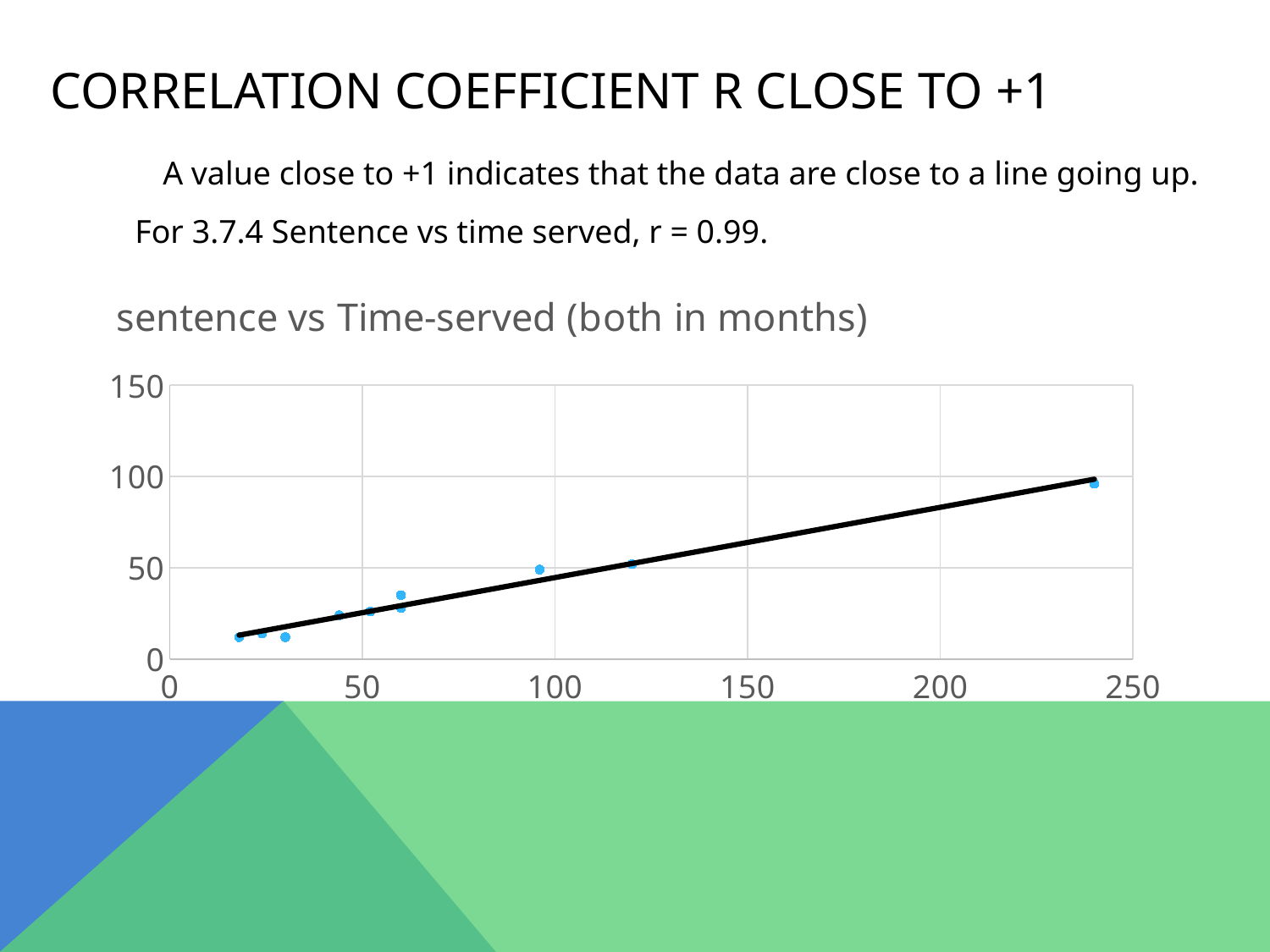
What is the title of the chart? sentence vs Time-served (both in months) What is the highest tick value shown on the y-axis? 150 Which point has the highest y value: the one near x = 240 or the one near x = 120? the one near x = 240 Are the values for the points near x = 20 to 30 greater or less than 50? less What kind of chart is shown on the slide? scatter chart Is the value for the point at the far right of the chart (near x = 240) greater or less than 150? less How many data points are plotted on the chart? 10 Do the plotted values rise or fall as the x-axis value increases? rise What is the highest tick value shown on the x-axis? 250 Is the value for the point at the far right of the chart (near x = 240) greater or less than 50? greater